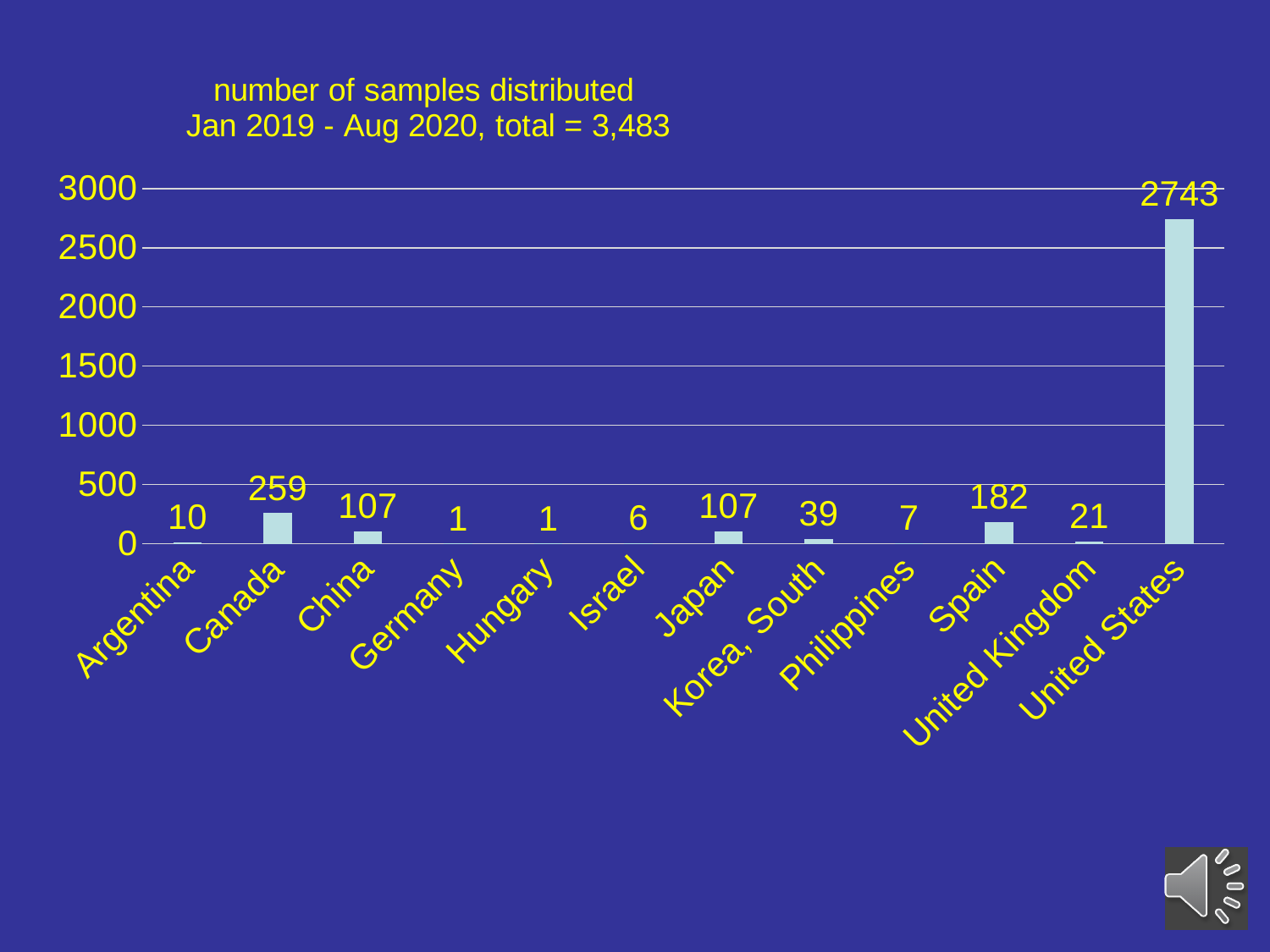
Is the value for the United States greater or less than 2500? greater How many countries are shown on the x axis? 12 What is the difference between the values for the United States and Canada? 2484 What is the value shown for Korea, South? 39 What is the difference between the values for Spain and China? 75 What kind of chart is shown on the slide? bar chart Which country received the highest number of samples? United States Which has a larger value, Canada or Spain? Canada How many samples were distributed to Canada? 259 What is the value shown for Spain? 182 What total is stated in the chart title? 3,483 What time period does the chart title say the samples cover? Jan 2019 - Aug 2020